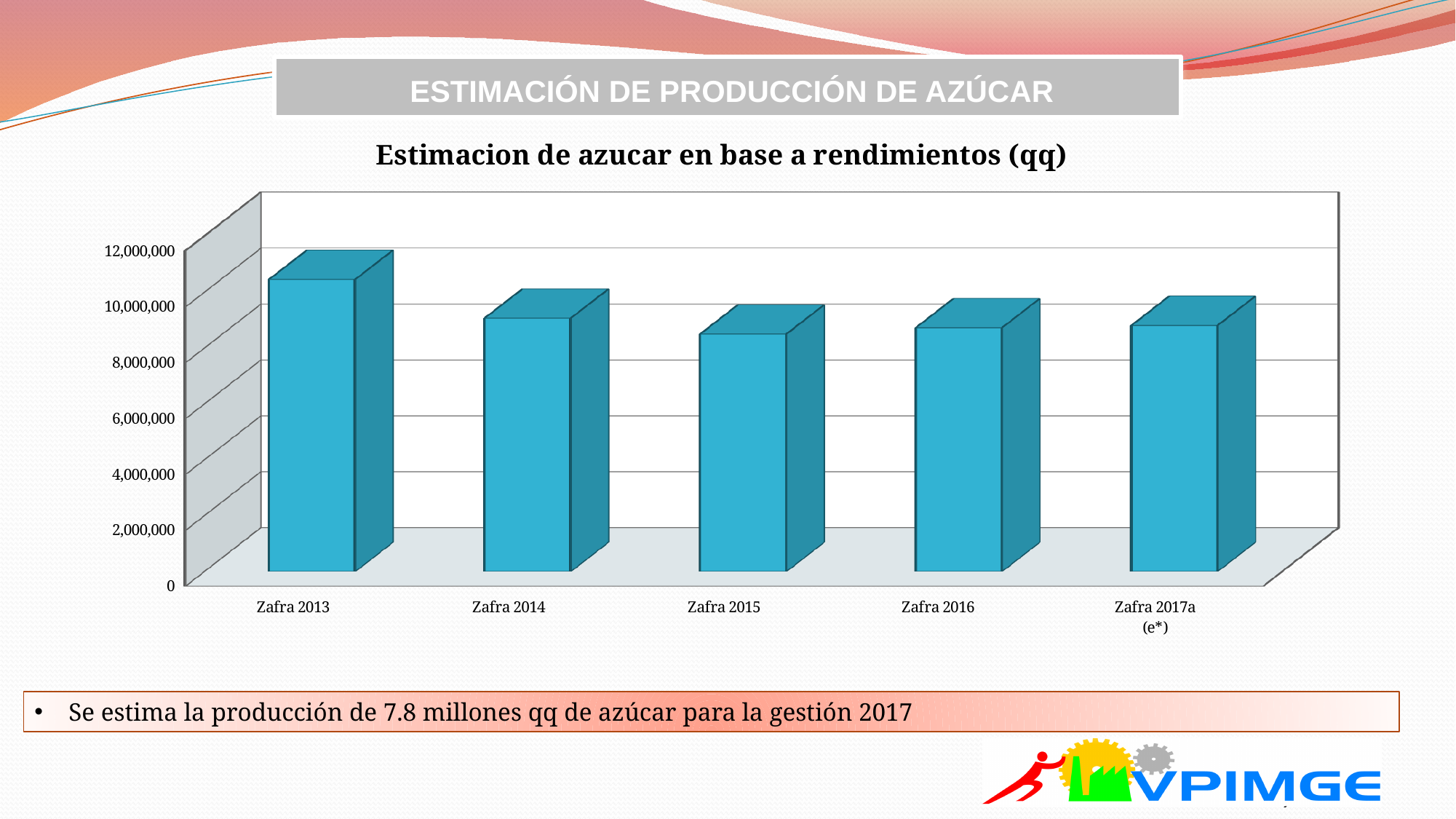
Which is larger, the value for Zafra 2013 or the value for Zafra 2014? Zafra 2013 Which zafra has the highest estimated sugar production in the chart? Zafra 2013 How many zafra categories are shown on the x axis of the chart? 5 Does the value rise or fall from Zafra 2013 to Zafra 2014? fall Is the value for Zafra 2014 greater or less than 10,000,000? less Which is larger, the value for Zafra 2014 or the value for Zafra 2015? Zafra 2014 Is the value for Zafra 2016 greater or less than 10,000,000? less What type of chart is shown on the slide? bar chart Is the value for Zafra 2017a (e*) greater or less than 6,000,000? greater What is the title of the chart? Estimacion de azucar en base a rendimientos (qq)